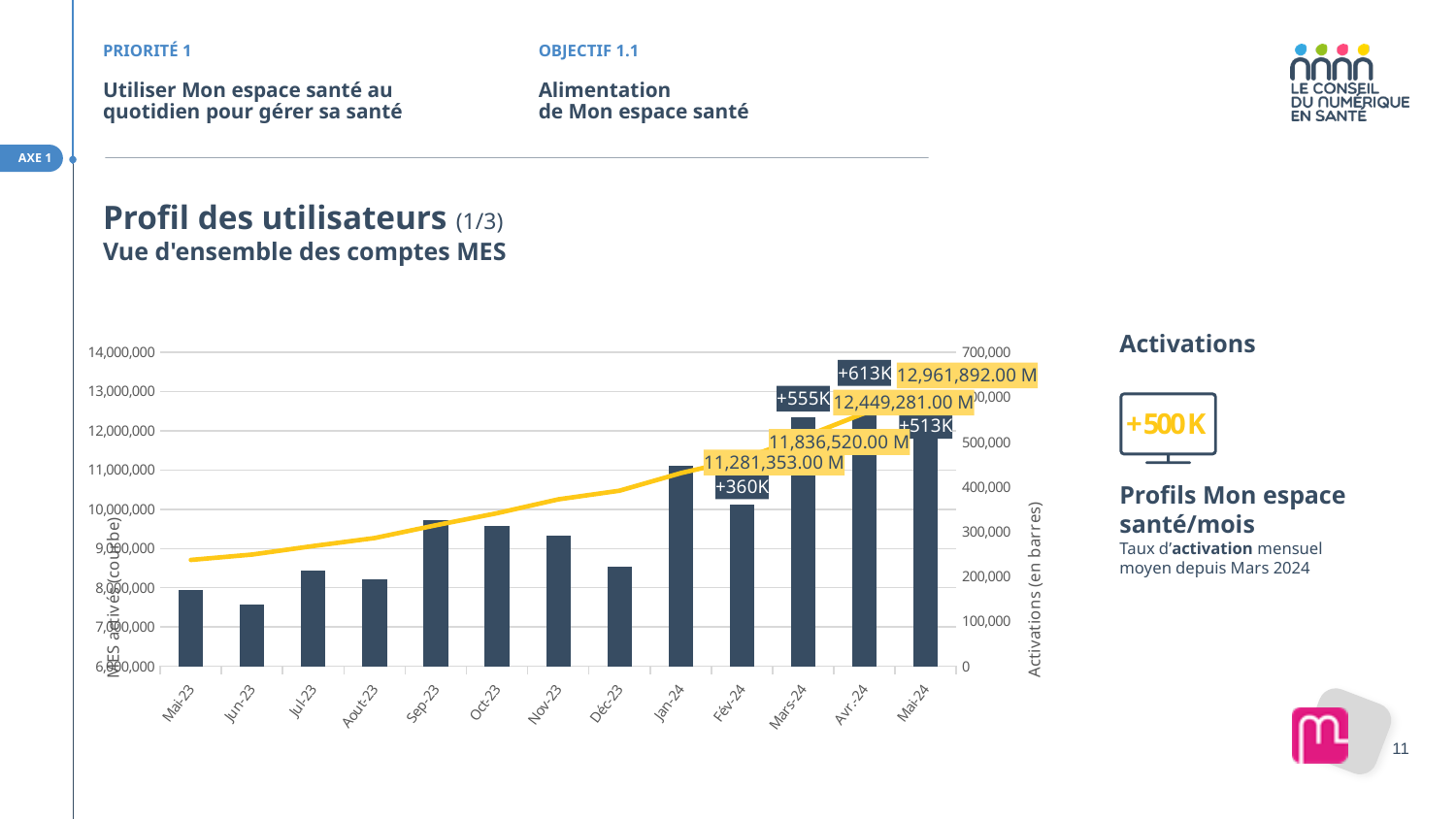
What is the label of the right-hand vertical axis of the chart? Activations (en barres) What is the activations value labelled on the bar for Avr-24? +613K Is the activations bar for Jan-24 greater or less than 400,000? greater Which month has the highest activations bar? Avr-24 Which month has the lowest activations bar? Jun-23 What value is labelled on the line for Mai-24? 12,961,892.00 M Does the line for MES activés rise or fall from Mai-23 to Mai-24? It rises How many months are shown along the x axis of the chart? 13 What is the difference between the labelled activations for Avr-24 (+613K) and Mai-24 (+513K)? 100K What is the activations value labelled on the bar for Fév-24? +360K What kind of chart is shown on the slide? A combined bar and line chart Which month has the larger activations bar, Fév-24 or Mars-24? Mars-24